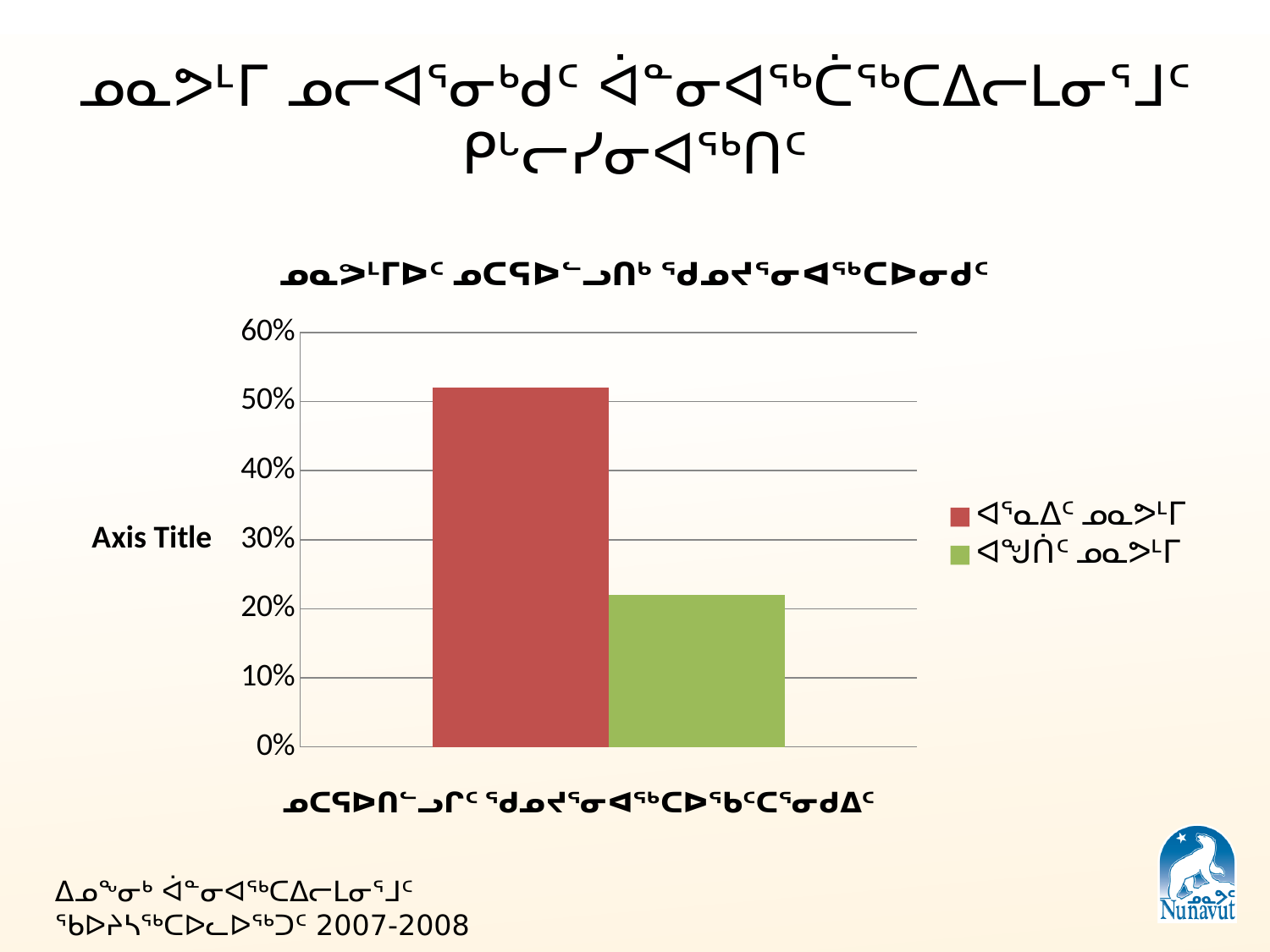
Which series has the highest value in the chart? the red series (first legend entry) Is the value of the red bar greater or less than 40%? greater Which bar is taller, the red bar or the green bar? the red bar What is the title shown on the vertical axis of the chart? Axis Title Is the value of the green bar greater or less than 10%? greater What kind of chart is shown on the slide? bar chart Is the value of the red bar greater or less than 60%? less What is the highest value labelled on the vertical axis of the chart? 60% Which series has the lowest value in the chart? the green series (second legend entry) How many series does the chart's legend list? 2 How many bars are plotted in the chart? 2